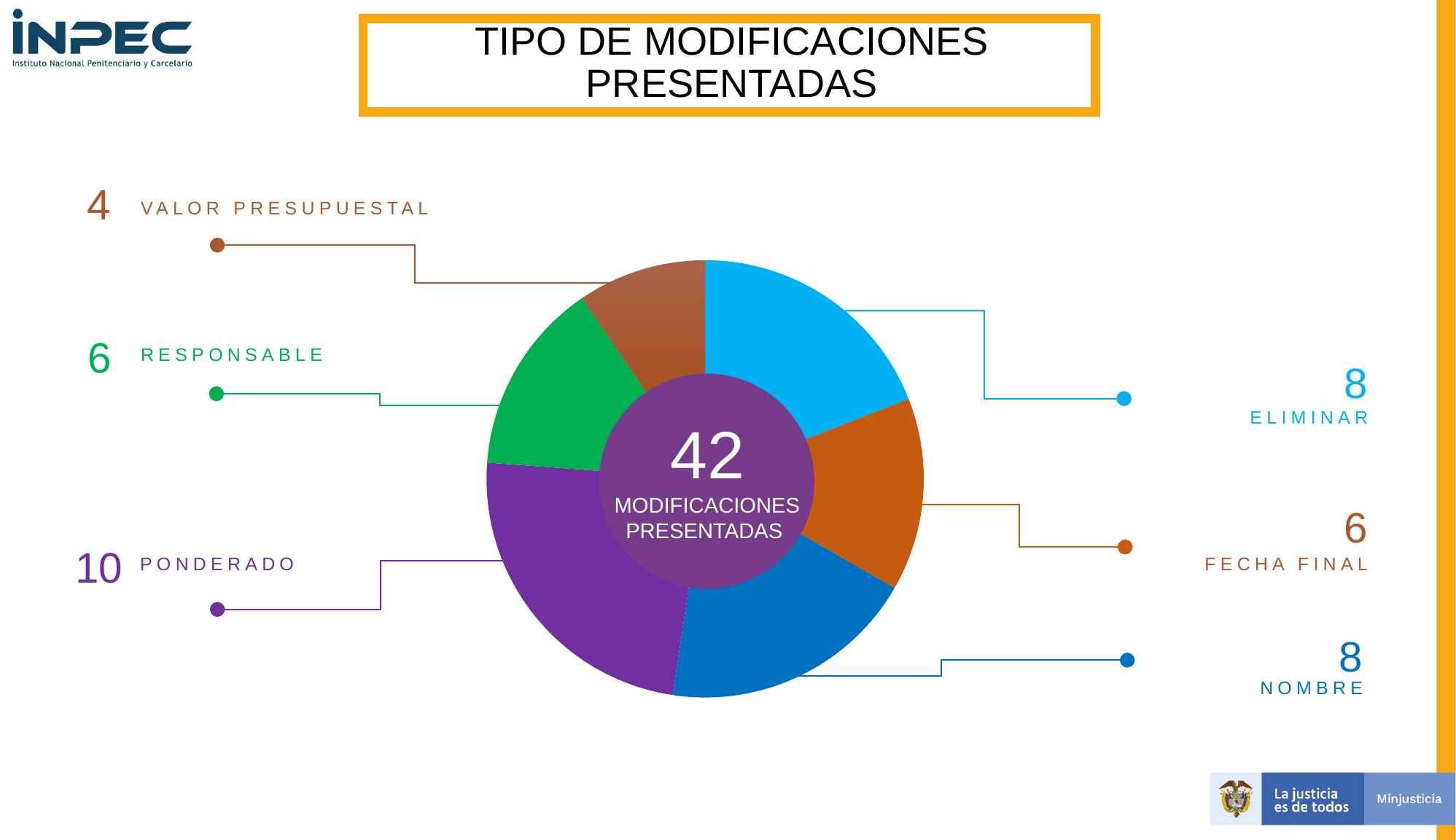
What is the title of the slide? TIPO DE MODIFICACIONES PRESENTADAS What kind of chart is shown on the slide? pie chart Which is larger, the value for NOMBRE or the value for FECHA FINAL? NOMBRE What is the value for ELIMINAR? 8 Which category has the lowest value? VALOR PRESUPUESTAL What is the value for FECHA FINAL? 6 What is the value for PONDERADO? 10 What is the difference between the values for PONDERADO and RESPONSABLE? 4 Which category has the highest value? PONDERADO What is the value for VALOR PRESUPUESTAL? 4 How many categories does the chart show? 6 What total number of modifications is shown in the centre of the chart? 42